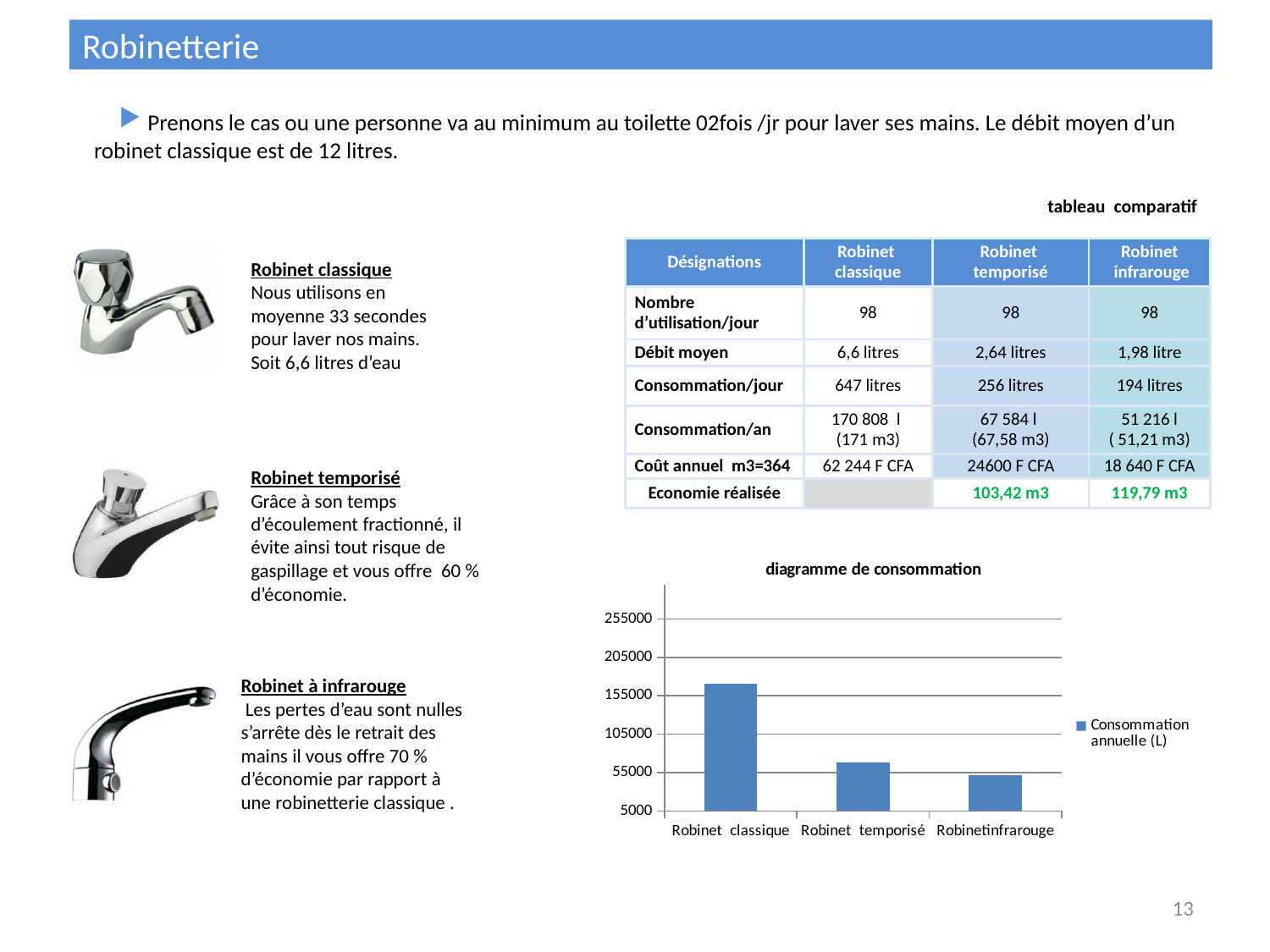
In the "diagramme de consommation" chart, which is larger: the value for Robinet classique or for Robinet temporisé? Robinet classique In the "diagramme de consommation" chart, which category has the highest bar? Robinet classique In the "diagramme de consommation" chart, is the value for Robinet temporisé greater or less than 105000? less How many series does the legend of the "diagramme de consommation" chart list? 1 In the "diagramme de consommation" chart, is the value for Robinetinfrarouge greater or less than 105000? less In the "diagramme de consommation" chart, is the value for Robinet classique greater or less than 155000? greater What kind of chart is the "diagramme de consommation"? bar chart How many categories are shown on the x axis of the "diagramme de consommation" chart? 3 In the "diagramme de consommation" chart, do the bar values rise or fall from left to right along the x axis? fall In the "diagramme de consommation" chart, which category has the lowest bar? Robinetinfrarouge What is the title of the bar chart on the slide? diagramme de consommation What is the legend entry of the series plotted in the "diagramme de consommation" chart? Consommation annuelle (L)